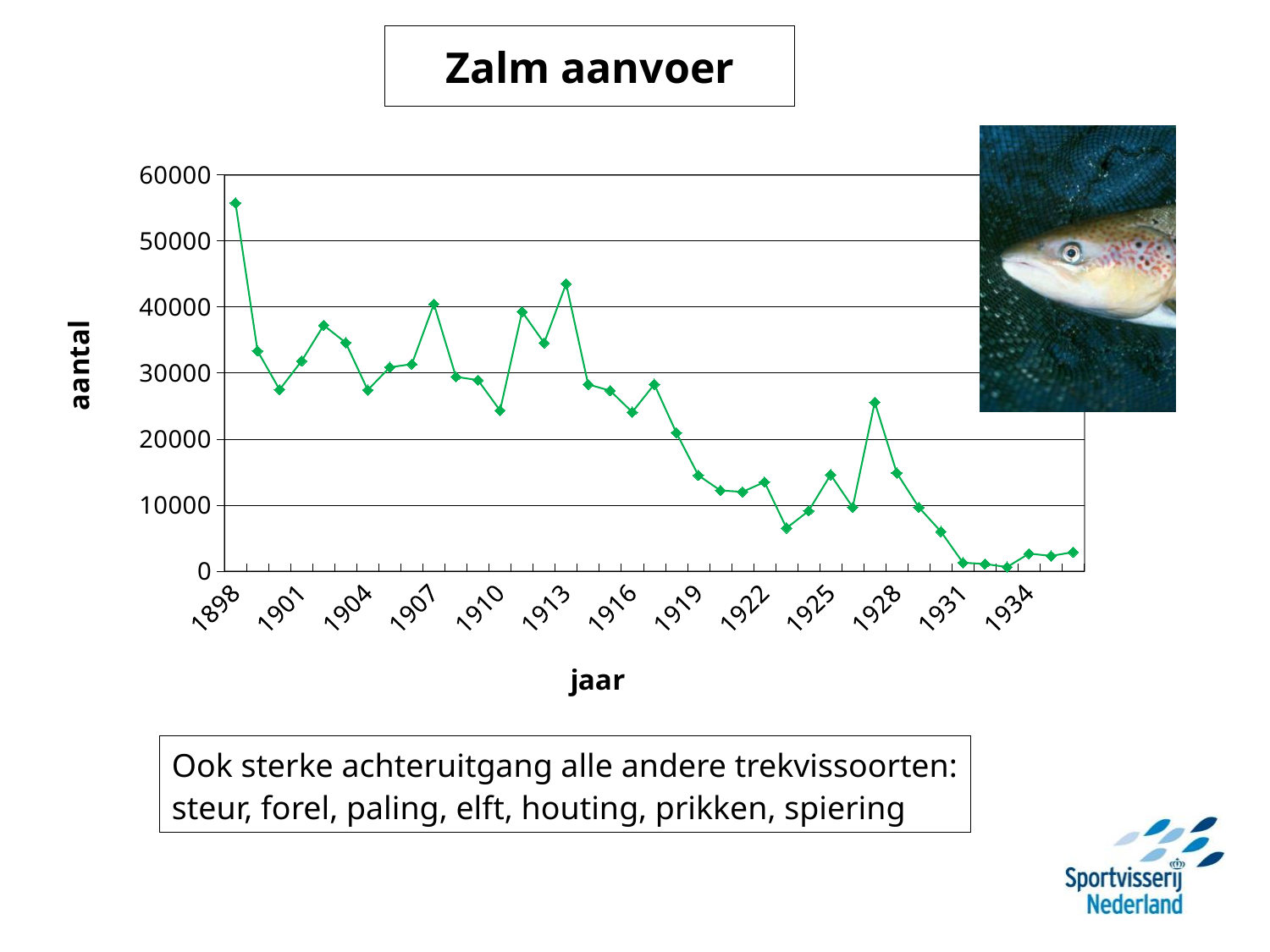
Which year has the larger value, 1898 or 1913? 1898 What is the label of the vertical axis of the chart? aantal Is the value for 1898 greater or less than 50000? greater Do the values generally rise or fall from 1898 to 1934? fall What kind of chart is shown on the slide? line chart Is the value for 1931 greater or less than 10000? less Is the value for 1927 greater or less than 20000? greater In which year is the value highest in the chart? 1898 What is the title of the chart? Zalm aanvoer Which year has the larger value, 1927 or 1928? 1927